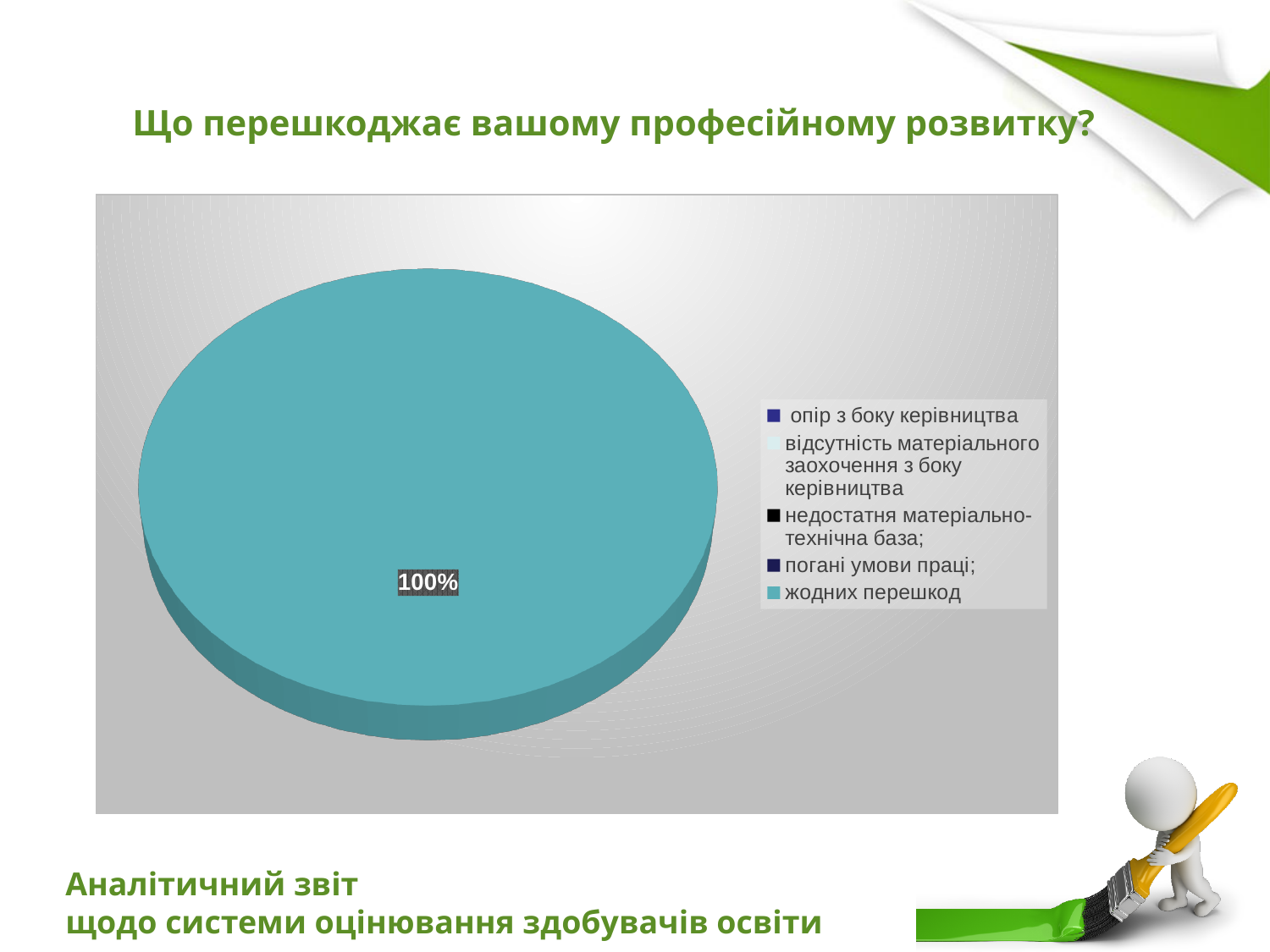
What is the title of the chart on the slide? Що перешкоджає вашому професійному розвитку? Which legend entry is listed first? опір з боку керівництва Which category accounts for the largest share of the pie? жодних перешкод Is the share for "жодних перешкод" greater or less than 50%? greater Which legend entry is listed last? жодних перешкод What share of the pie does "жодних перешкод" take? 100% Which is larger: the share for "жодних перешкод" or the share for "погані умови праці"? жодних перешкод What kind of chart is shown on the slide? pie chart What percentage is shown on the pie slice for "жодних перешкод"? 100% How many entries does the legend list? 5